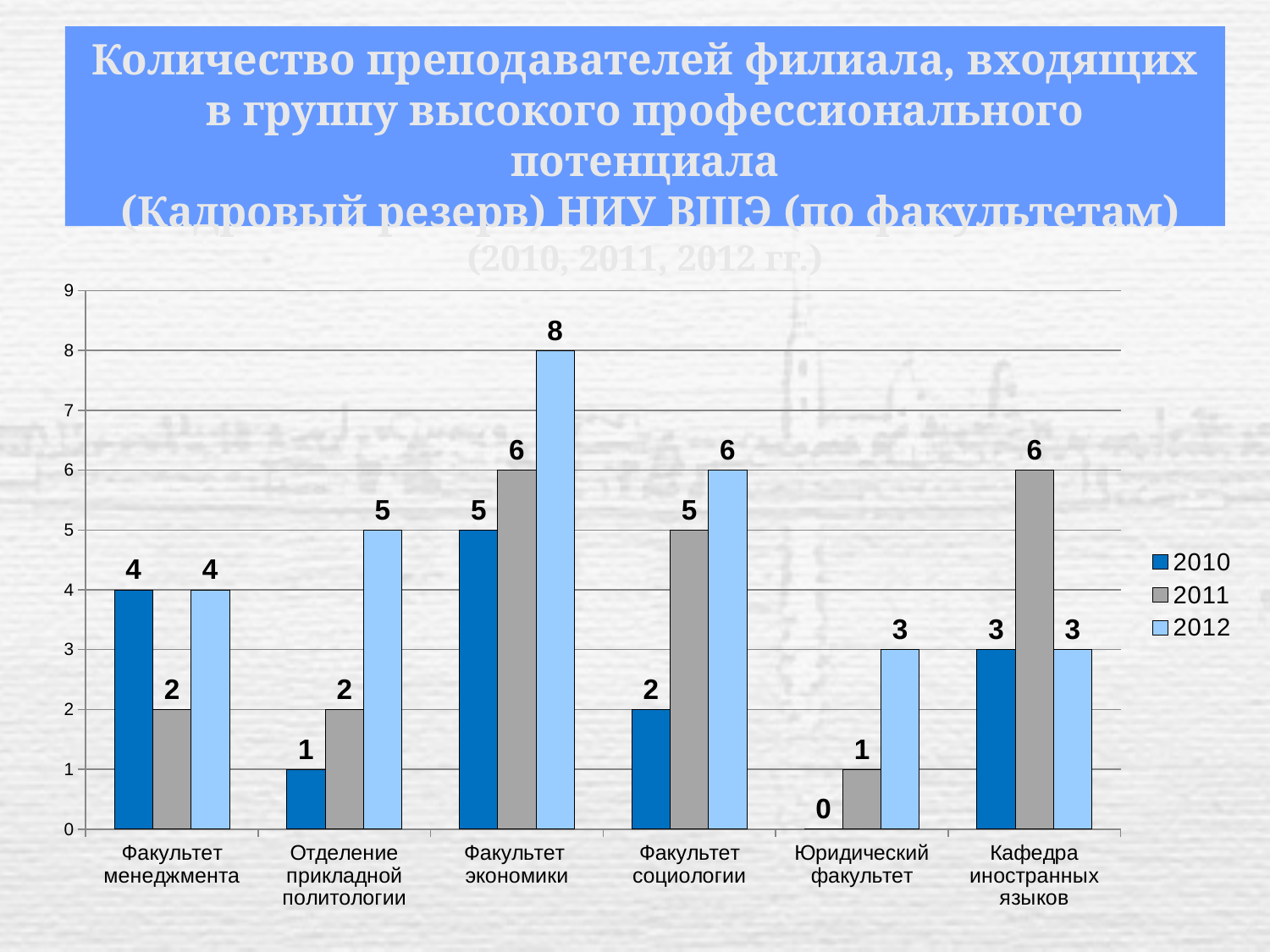
How many faculty categories are shown on the x axis? 6 Which years are listed in the legend? 2010, 2011, 2012 What is the difference between the 2012 and 2010 values for Отделение прикладной политологии? 4 What kind of chart is shown on the slide? bar chart Which faculty has the highest value in 2012? Факультет экономики Do the values for Факультет экономики rise or fall from 2010 to 2012? rise What is the value for Кафедра иностранных языков in 2011? 6 Which faculty has the lowest value in 2010? Юридический факультет How many series does the legend list? 3 What is the value for Факультет экономики in 2012? 8 Which is larger for Факультет социологии: the 2011 value or the 2012 value? 2012 What is the value for Юридический факультет in 2010? 0